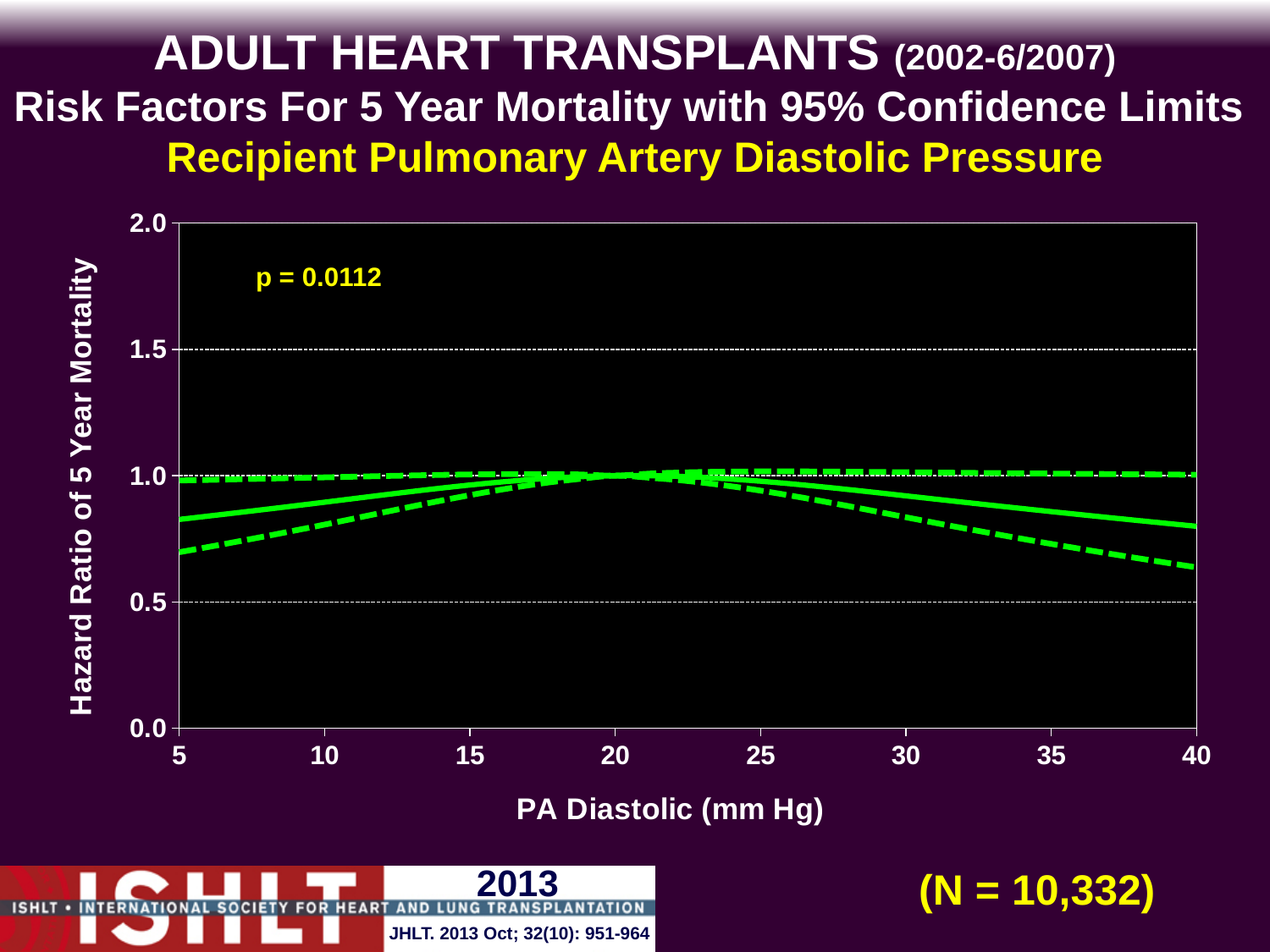
Is the lower dashed confidence limit at a PA diastolic pressure of 5 mm Hg greater or less than 0.5? greater What sample size (N) is shown on the slide? N = 10,332 What p-value is printed on the chart? p = 0.0112 Is the lower dashed confidence limit at a PA diastolic pressure of 40 mm Hg greater or less than 1.0? less Is the hazard ratio on the solid line higher at a PA diastolic pressure of 5 mm Hg or at 20 mm Hg? 20 mm Hg Is the hazard ratio on the solid line at a PA diastolic pressure of 5 mm Hg greater or less than 1.0? less How many lines are plotted on the chart? 3 Does the solid hazard ratio line rise or fall as PA diastolic pressure increases from 5 to 20 mm Hg? rise What kind of chart is shown on the slide? line chart Does the solid hazard ratio line rise or fall as PA diastolic pressure increases from 20 to 40 mm Hg? fall